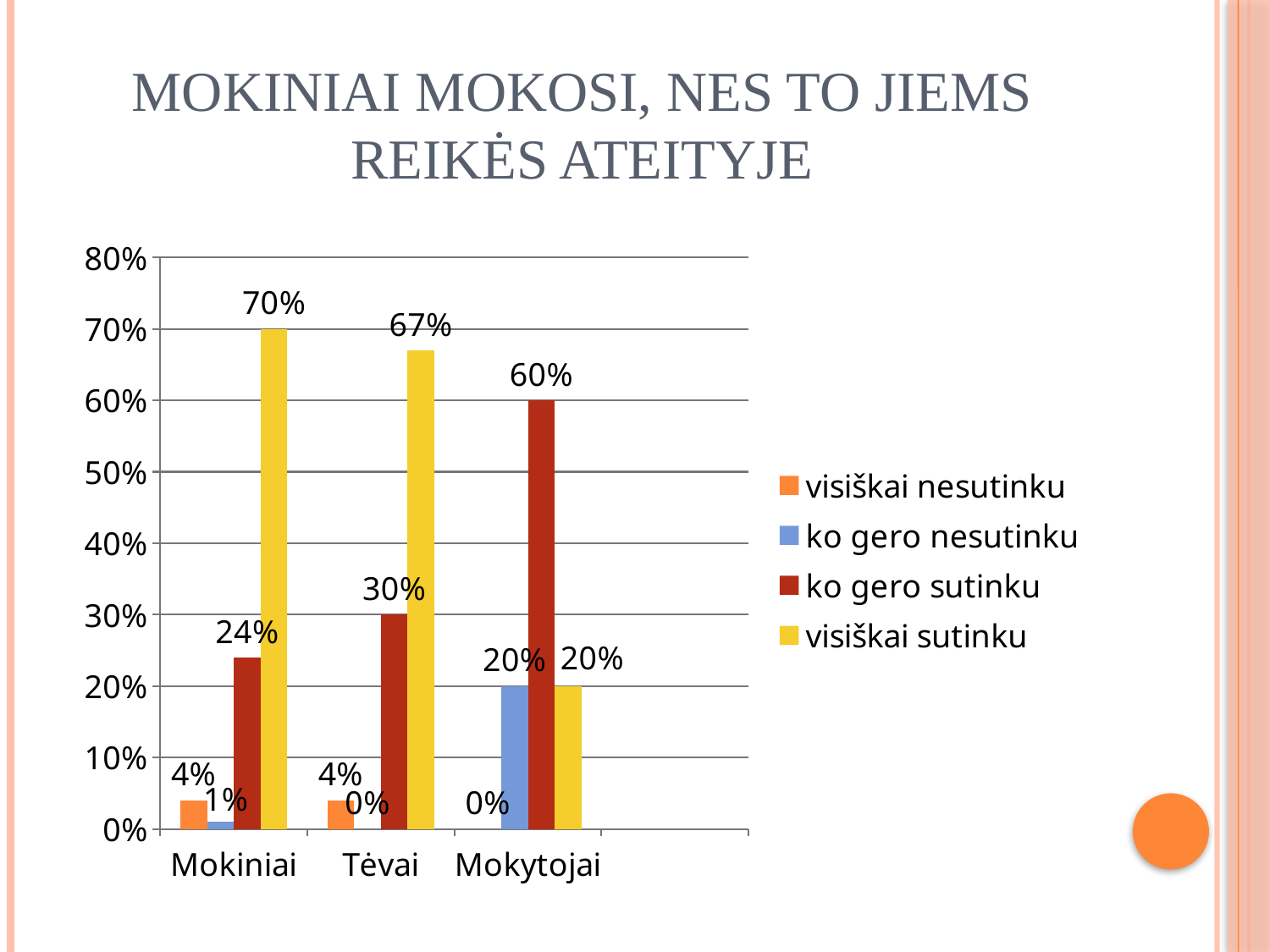
How many series does the legend list? 4 Which is larger: 'ko gero sutinku' for Mokytojai or 'visiškai sutinku' for Mokytojai? ko gero sutinku What is the value of 'visiškai sutinku' for Mokiniai? 70% What kind of chart is shown on the slide? bar chart Which category has the highest value for 'ko gero sutinku'? Mokytojai What is the difference between the 'visiškai sutinku' values for Mokiniai and Tėvai? 3% What is the value of 'ko gero nesutinku' for Mokiniai? 1% Which category has the lowest value for 'visiškai sutinku'? Mokytojai What is the value of 'ko gero sutinku' for Tėvai? 30% What is the value of 'ko gero nesutinku' for Mokytojai? 20% Which series is shown in yellow in the legend? visiškai sutinku How many categories are shown on the x axis? 3